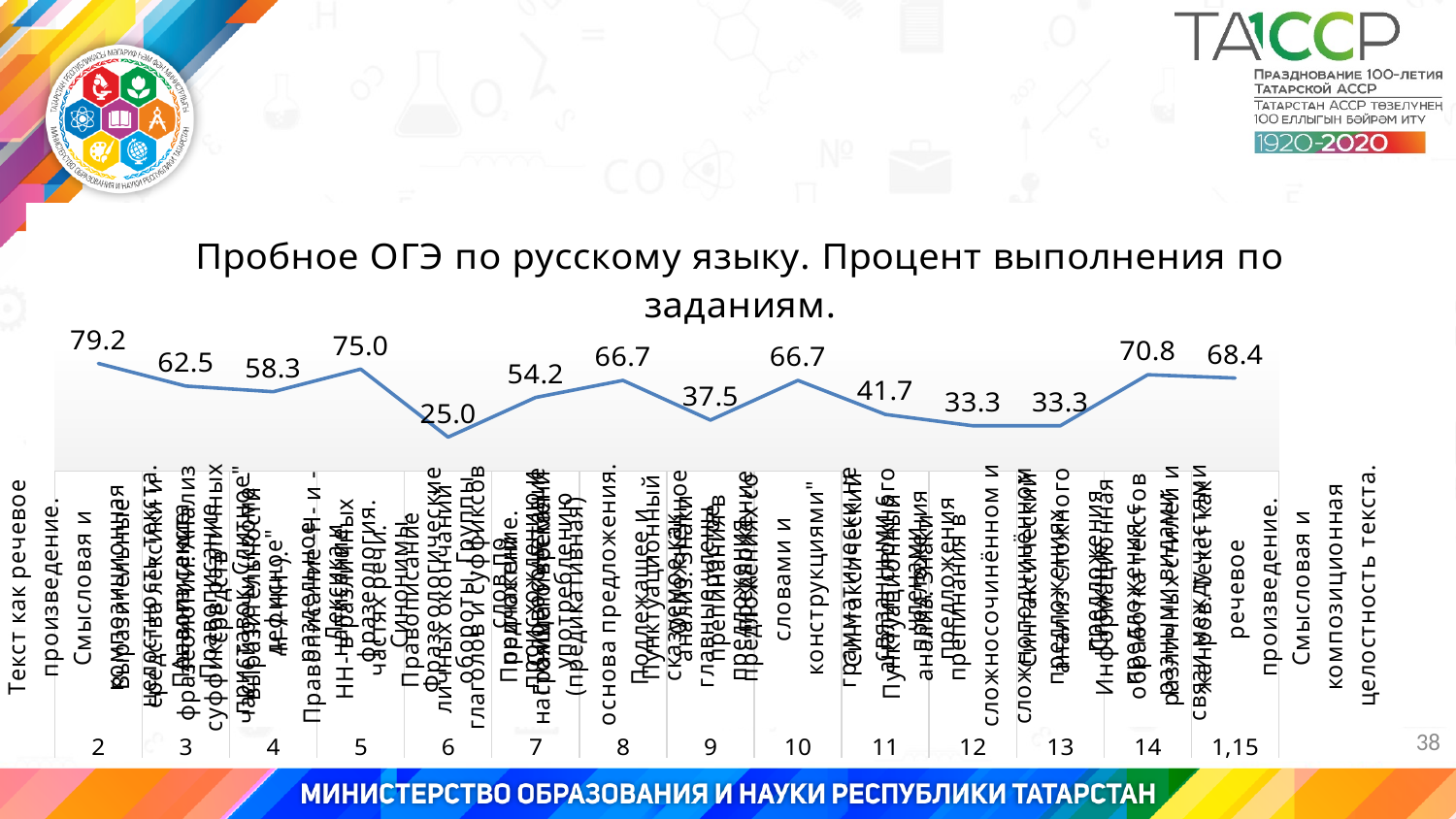
What is the percentage of completion for task 2? 79.2 What value is shown for the category labelled 1,15? 68.4 Which task has the lowest percentage of completion? 6 What is the difference between the values for task 5 and task 6? 50.0 Which task has the highest percentage of completion? 2 What is the difference between the values for task 2 and task 3? 16.7 Which has a higher value, task 9 or task 10? 10 Do the values rise or fall from task 2 to task 4? fall How many data points are plotted on the chart? 14 What type of chart is shown on the slide? line chart What is the percentage of completion for task 14? 70.8 What is the percentage of completion for task 6? 25.0